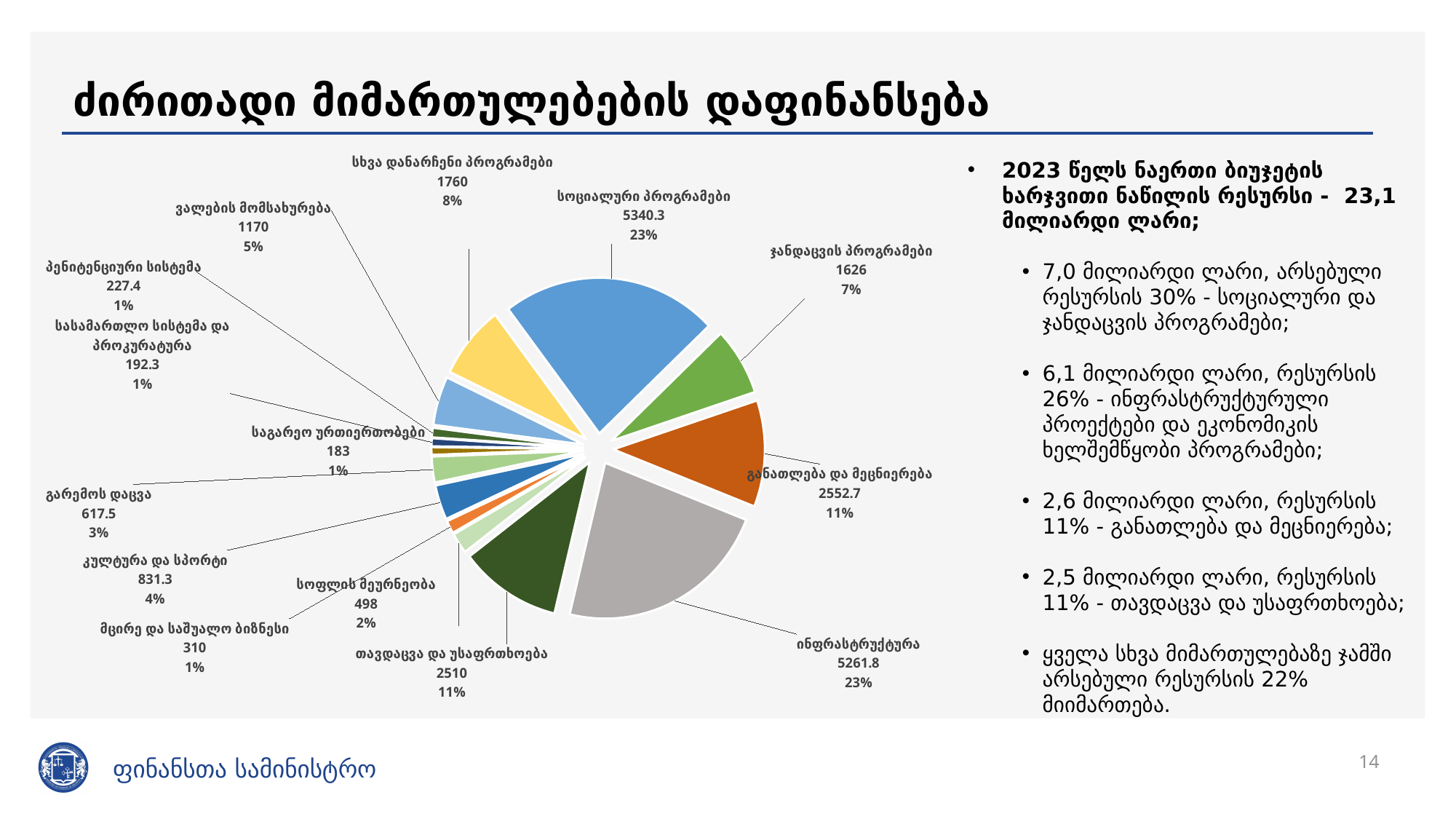
Which category has the smallest value in the pie chart? საგარეო ურთიერთობები What percentage share is shown for განათლება და მეცნიერება? 11% What is the difference between the values for სოციალური პროგრამები and ინფრასტრუქტურა? 78.5 What is the value shown for თავდაცვა და უსაფრთხოება? 2510 Which is larger: the value for კულტურა და სპორტი or the value for გარემოს დაცვა? კულტურა და სპორტი Which category has the largest value in the pie chart? სოციალური პროგრამები How many categories (slices) does the pie chart have? 14 What type of chart is shown on the slide? pie chart What is the value shown for სოფლის მეურნეობა? 498 What is the value shown for სოციალური პროგრამები? 5340.3 What percentage share is shown for ვალების მომსახურება? 5% What is the value shown for ინფრასტრუქტურა? 5261.8